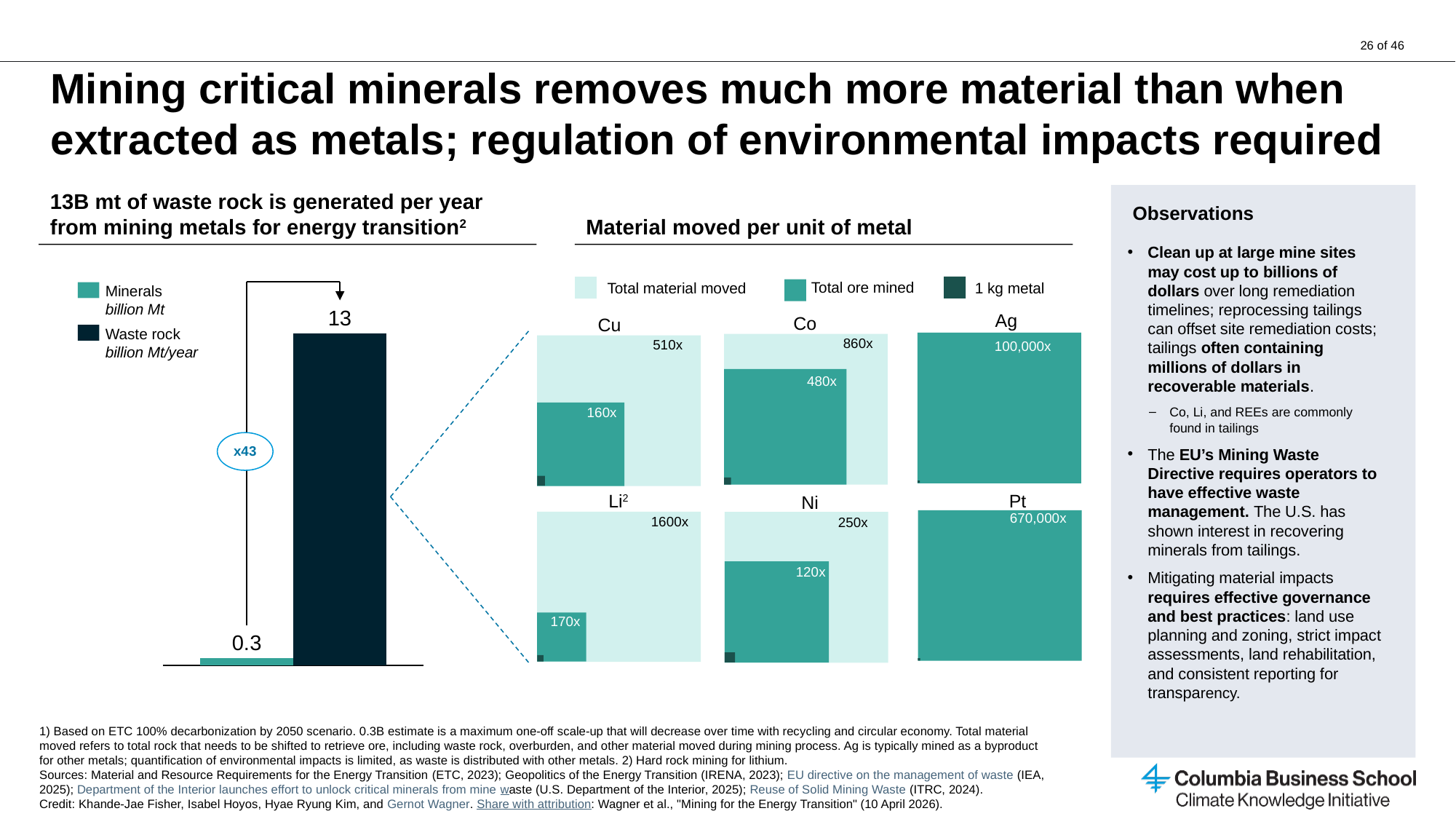
What kind of chart is the chart on the left of the slide? Bar chart How many entries does the legend of the left bar chart list? 2 In the 'Material moved per unit of metal' chart, what is the total material moved value for Cu? 510x In the left bar chart, what is the value shown for Minerals? 0.3 In the 'Material moved per unit of metal' chart, what is the total ore mined value for Co? 480x How many entries does the legend of the 'Material moved per unit of metal' chart list? 3 How many metals are shown in the 'Material moved per unit of metal' chart? 6 In the left bar chart, what is the value shown for Waste rock? 13 In the left bar chart, what is the difference between the Waste rock value and the Minerals value? 12.7 In the 'Material moved per unit of metal' chart, what is the value shown for Pt? 670,000x In the 'Material moved per unit of metal' chart, which metal has the highest total material moved value? Pt In the left bar chart, what multiplier is shown in the circle between the two bars? x43